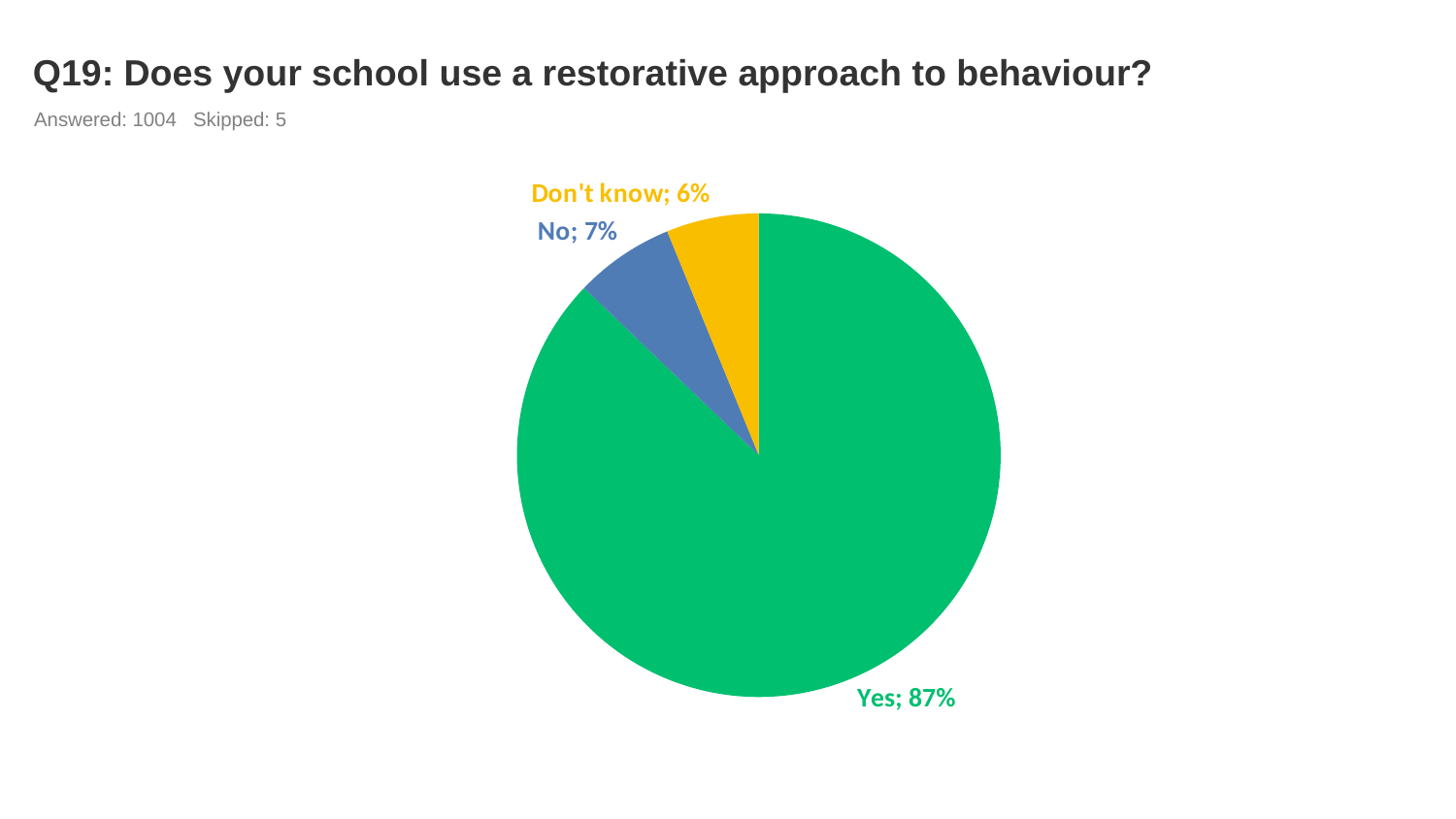
How many respondents answered the question according to the slide? 1004 How many slices does the pie chart have? 3 What is the difference in percentage points between the Yes and No slices? 80 Which slice is larger, Yes or No? Yes What share of respondents answered No? 7% Which response has the largest slice of the pie? Yes What kind of chart is shown on the slide? pie chart What is the difference in percentage points between the No and Don't know slices? 1 What share of respondents answered Yes? 87% Which response has the smallest slice of the pie? Don't know What share of respondents answered Don't know? 6% What is the title of the chart? Q19: Does your school use a restorative approach to behaviour?